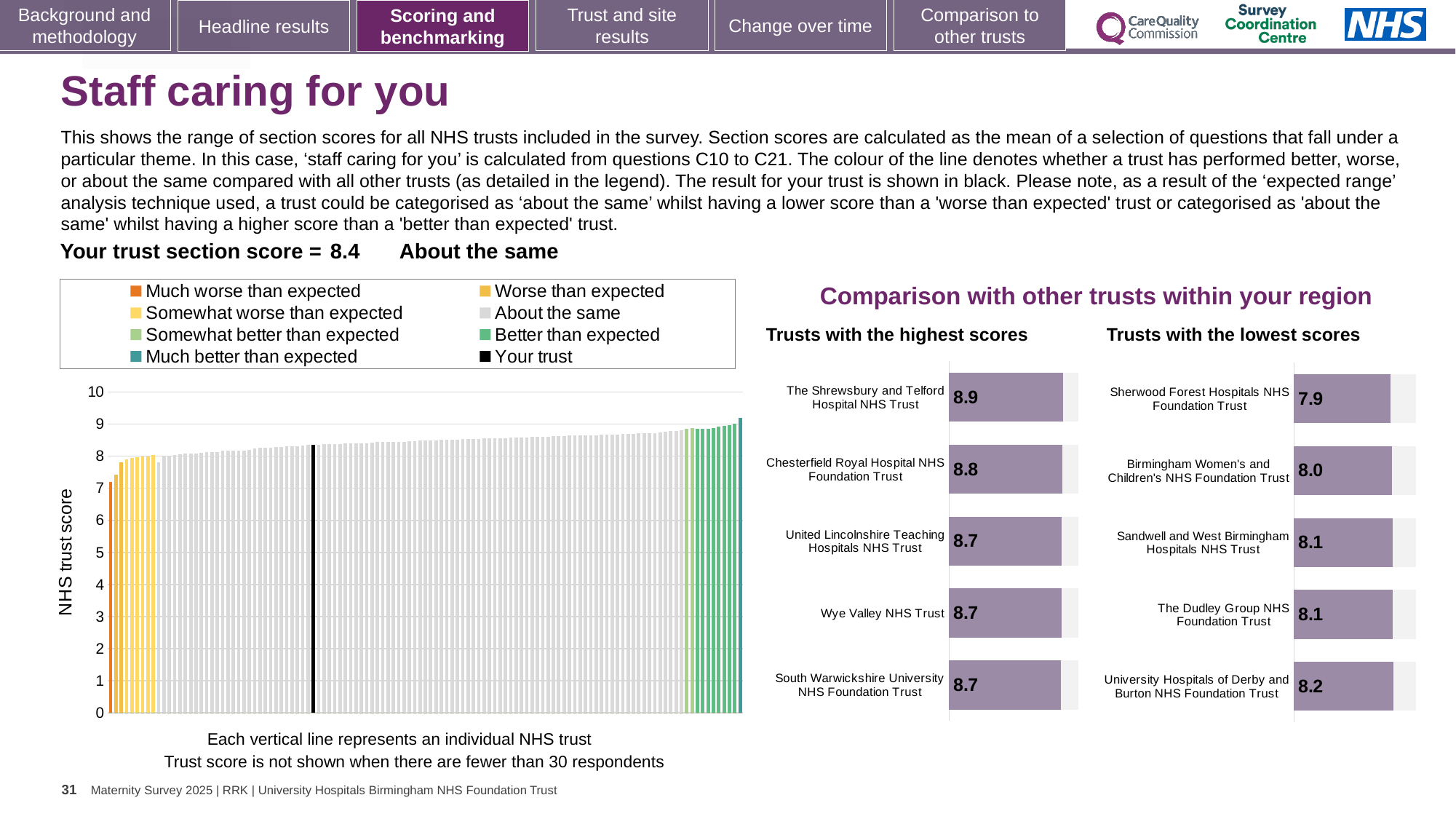
In the 'Trusts with the lowest scores' chart, which trust has the lowest score? Sherwood Forest Hospitals NHS Foundation Trust How many trusts are shown in the 'Trusts with the highest scores' chart? 5 In the 'Trusts with the lowest scores' chart, what is the difference between the scores of University Hospitals of Derby and Burton NHS Foundation Trust and Sherwood Forest Hospitals NHS Foundation Trust? 0.3 In the 'Trusts with the highest scores' chart, what is the difference between the scores of The Shrewsbury and Telford Hospital NHS Trust and Chesterfield Royal Hospital NHS Foundation Trust? 0.1 In the 'Trusts with the highest scores' chart, what is the score for Wye Valley NHS Trust? 8.7 How many entries does the legend of the main 'NHS trust score' chart list? 8 What kind of chart is the main chart on the left with the 'NHS trust score' axis? Bar chart In the 'Trusts with the lowest scores' chart, what is the score for Sherwood Forest Hospitals NHS Foundation Trust? 7.9 In the 'Trusts with the highest scores' chart, what is the score for The Shrewsbury and Telford Hospital NHS Trust? 8.9 In the 'Trusts with the lowest scores' chart, which has the higher score: Birmingham Women's and Children's NHS Foundation Trust or Sandwell and West Birmingham Hospitals NHS Trust? Sandwell and West Birmingham Hospitals NHS Trust In the main 'NHS trust score' chart, do the values rise or fall from left to right? Rise In the 'Trusts with the highest scores' chart, which trust has the highest score? The Shrewsbury and Telford Hospital NHS Trust